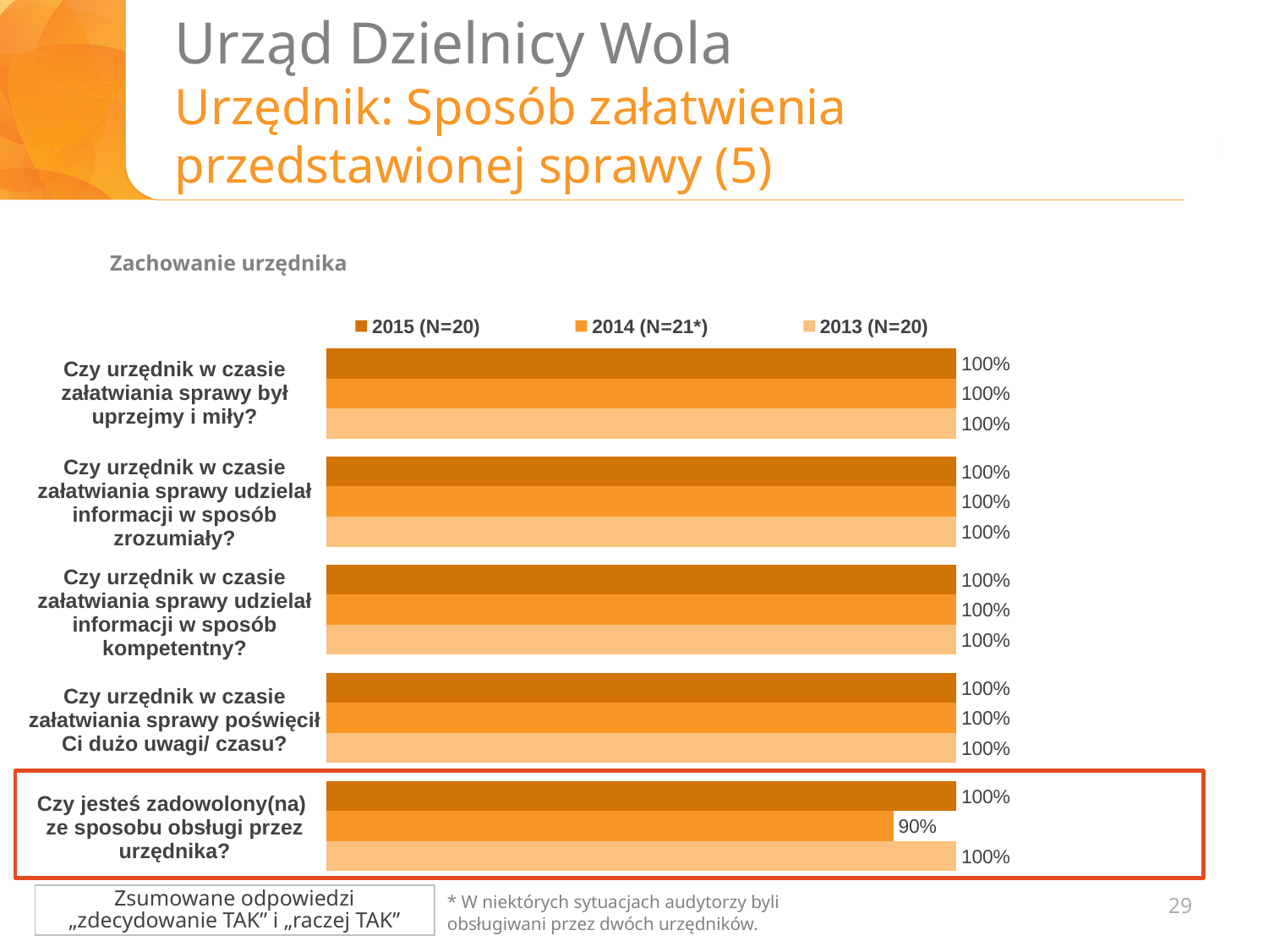
What is the 2015 (N=20) value for "Czy jesteś zadowolony(na) ze sposobu obsługi przez urzędnika?"? 100% What is the subtitle printed above the chart? Zachowanie urzędnika What kind of chart is shown on the slide? bar chart Which series has the lowest value for "Czy jesteś zadowolony(na) ze sposobu obsługi przez urzędnika?"? 2014 (N=21*) What is the 2014 (N=21*) value for "Czy jesteś zadowolony(na) ze sposobu obsługi przez urzędnika?"? 90% For "Czy jesteś zadowolony(na) ze sposobu obsługi przez urzędnika?", which is larger: the 2013 (N=20) value or the 2014 (N=21*) value? 2013 (N=20) How many series does the chart legend list? 3 What is the 2013 (N=20) value for "Czy urzędnik w czasie załatwiania sprawy był uprzejmy i miły?"? 100% What is the sample size shown in the legend for the 2014 series? N=21* How many question categories are plotted in the chart? 5 What is the difference between the 2015 (N=20) and 2014 (N=21*) values for "Czy jesteś zadowolony(na) ze sposobu obsługi przez urzędnika?"? 10% What is the 2014 (N=21*) value for "Czy urzędnik w czasie załatwiania sprawy poświęcił Ci dużo uwagi/ czasu?"? 100%